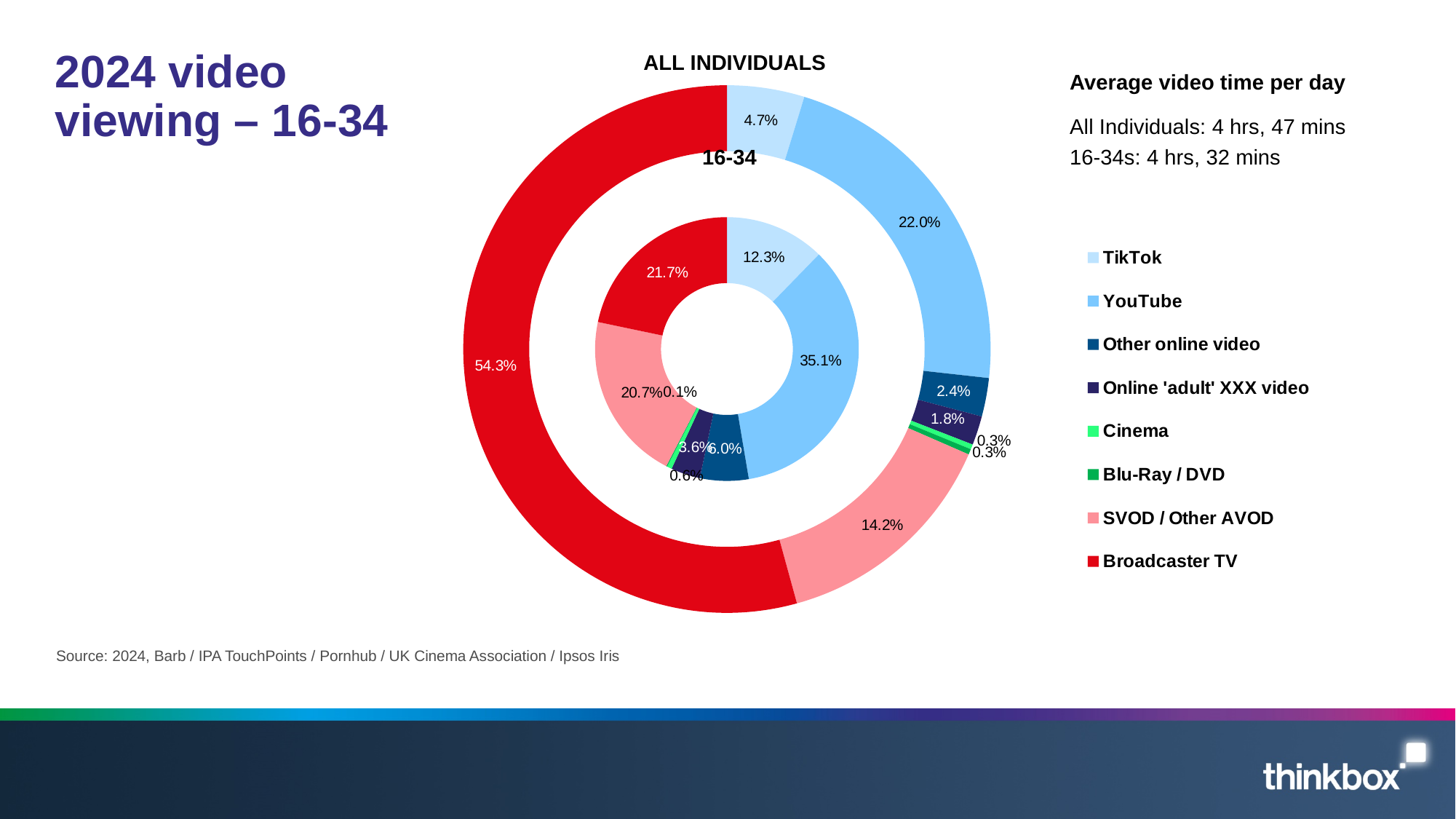
Which category has the largest share in the inner ring (16-34)? YouTube What is the difference between the Broadcaster TV share for ALL INDIVIDUALS (54.3%) and for 16-34 (21.7%)? 32.6% Which category has the largest share in the outer ring (ALL INDIVIDUALS)? Broadcaster TV In the inner ring (16-34), what share does YouTube have? 35.1% What is the difference between the YouTube share for 16-34 (35.1%) and for ALL INDIVIDUALS (22.0%)? 13.1% What colour represents Broadcaster TV in the chart? red In the outer ring (ALL INDIVIDUALS), what share does Broadcaster TV have? 54.3% How many categories does the legend list? 8 What kind of chart is shown on the slide? doughnut chart In the inner ring (16-34), what share does TikTok have? 12.3% In the outer ring (ALL INDIVIDUALS), what share does SVOD / Other AVOD have? 14.2% In the inner ring (16-34), which is larger: Broadcaster TV or SVOD / Other AVOD? Broadcaster TV